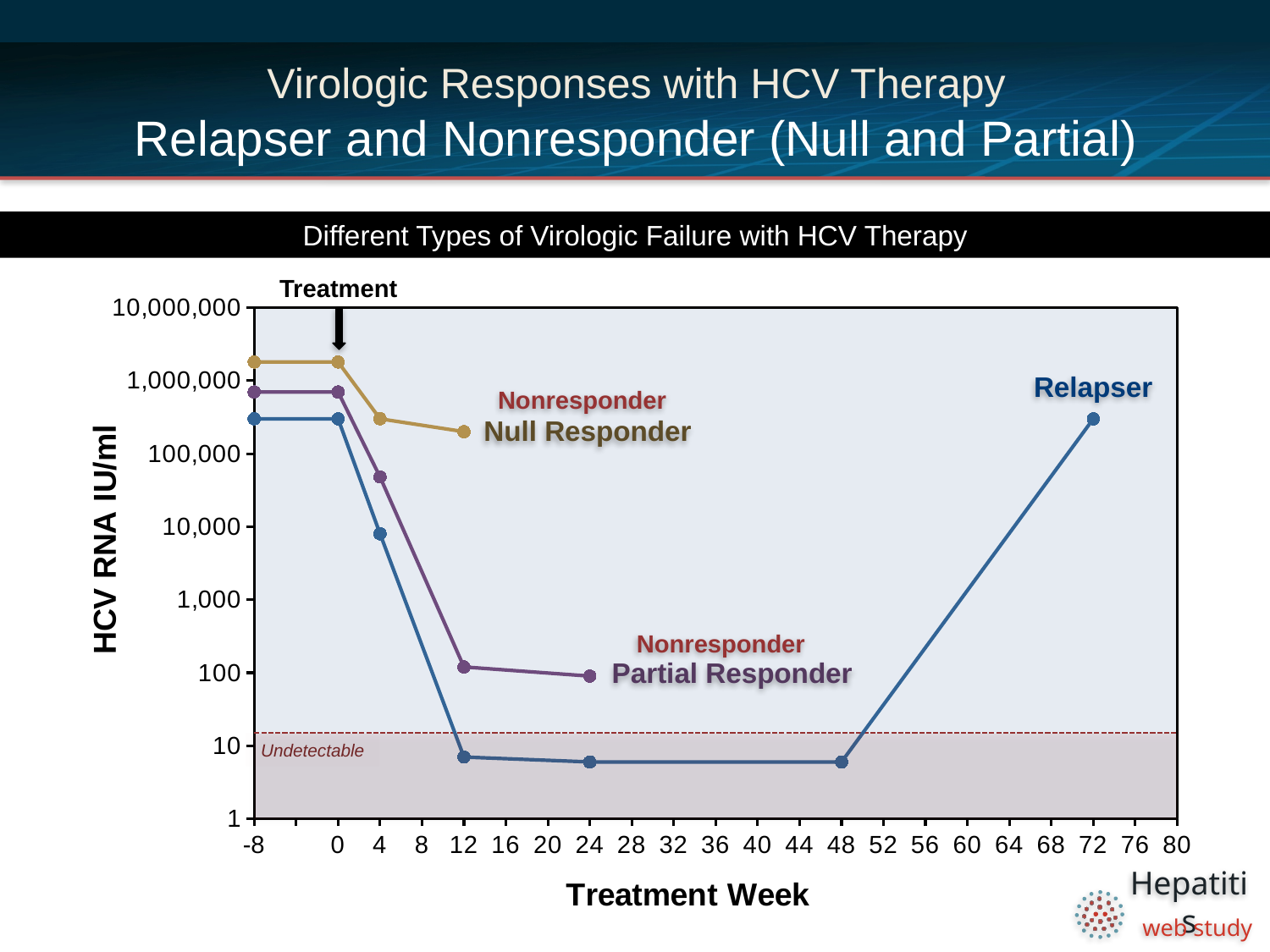
Is the Relapser value at treatment week 24 greater or less than 10? less What is the title of the chart? Different Types of Virologic Failure with HCV Therapy Does the Relapser series rise or fall between treatment week 48 and week 72? Rise How many data points are plotted for the Relapser series? 7 Is the Partial Responder value at treatment week 4 greater or less than 100,000? less How many series (patient response types) are plotted on the chart? 3 At treatment week 12, which series has the higher HCV RNA value, Relapser or Partial Responder? Partial Responder Is the Relapser value at treatment week 72 greater or less than 100,000? greater What kind of chart is shown on the slide? Line chart What is the label of the y-axis? HCV RNA IU/ml